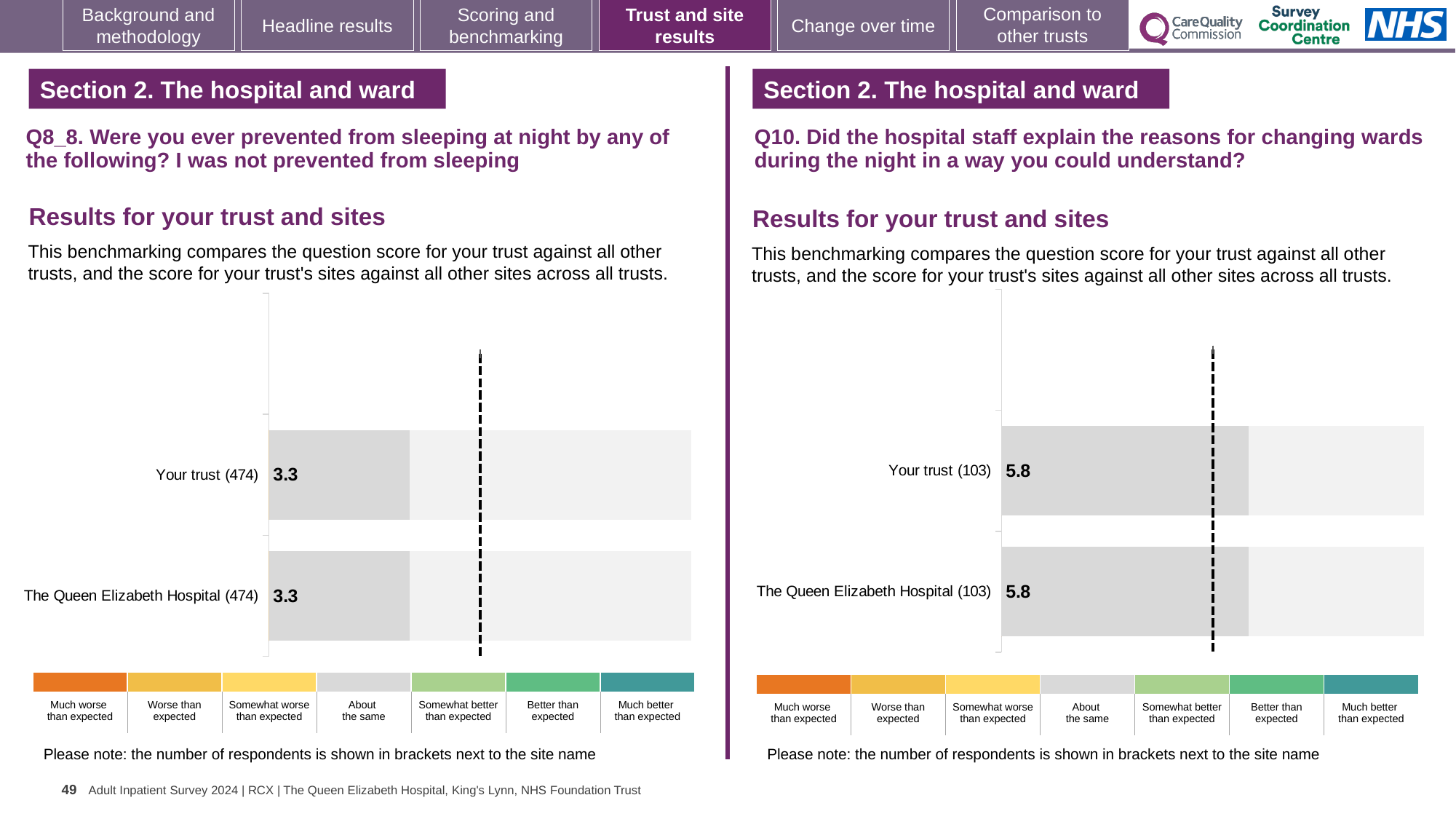
In the left chart (Q8_8), what is the score for Your trust? 3.3 What kind of chart is used in the left chart (Q8_8)? Bar chart How many bars are plotted in the left chart (Q8_8)? 2 Is the score for Your trust in the right chart (Q10) larger or smaller than the score for Your trust in the left chart (Q8_8)? Larger In the right chart (Q10), what is the score for The Queen Elizabeth Hospital? 5.8 In the left chart (Q8_8), what is the difference between the score for Your trust and the score for The Queen Elizabeth Hospital? 0 In the right chart (Q10), what is the score for Your trust? 5.8 In the right chart (Q10), how many respondents are shown in brackets for The Queen Elizabeth Hospital? 103 In the right chart (Q10), what is the difference between the score for Your trust and the score for The Queen Elizabeth Hospital? 0 In the left chart (Q8_8), how many respondents are shown in brackets for Your trust? 474 In the left chart (Q8_8), what is the score for The Queen Elizabeth Hospital? 3.3 How many bars are plotted in the right chart (Q10)? 2